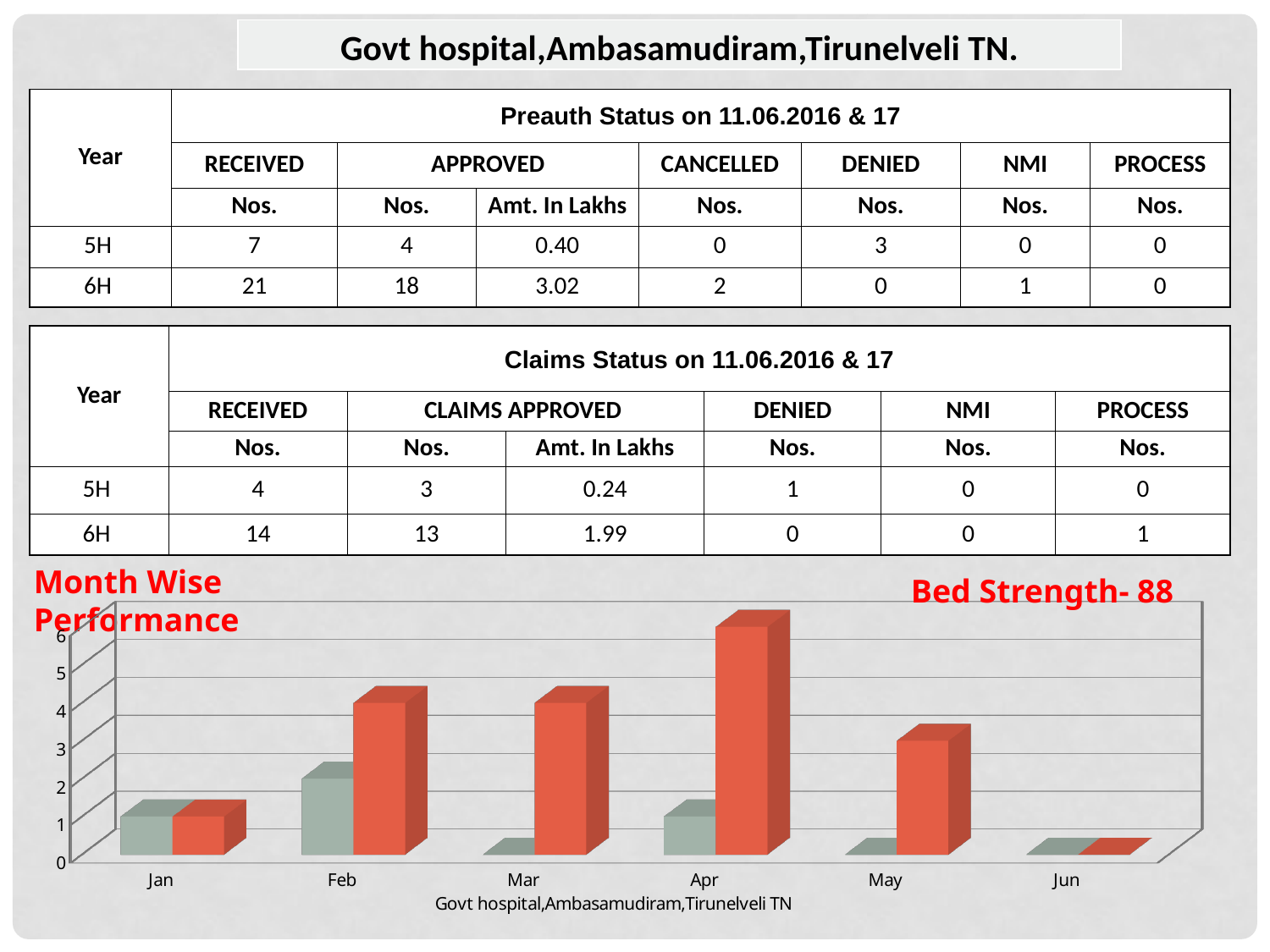
What kind of chart is shown at the bottom of the slide? bar chart In the Month Wise Performance chart, is the red bar for Feb greater or less than 3? greater In the Month Wise Performance chart, is the grey bar for Jan greater or less than 2? less In the Month Wise Performance chart, which month has the tallest grey bar? Feb In the Month Wise Performance chart, is the red bar for Apr greater or less than 5? greater In the Month Wise Performance chart, which is larger: the grey bar for Feb or the grey bar for Mar? Feb What text appears below the x axis of the Month Wise Performance chart? Govt hospital,Ambasamudiram,Tirunelveli TN How many months are shown on the x axis of the Month Wise Performance chart? 6 In the Month Wise Performance chart, which month has the lowest red bar? Jun In the Month Wise Performance chart, which month has the tallest red bar? Apr In the Month Wise Performance chart, which is larger: the red bar for Apr or the red bar for May? Apr